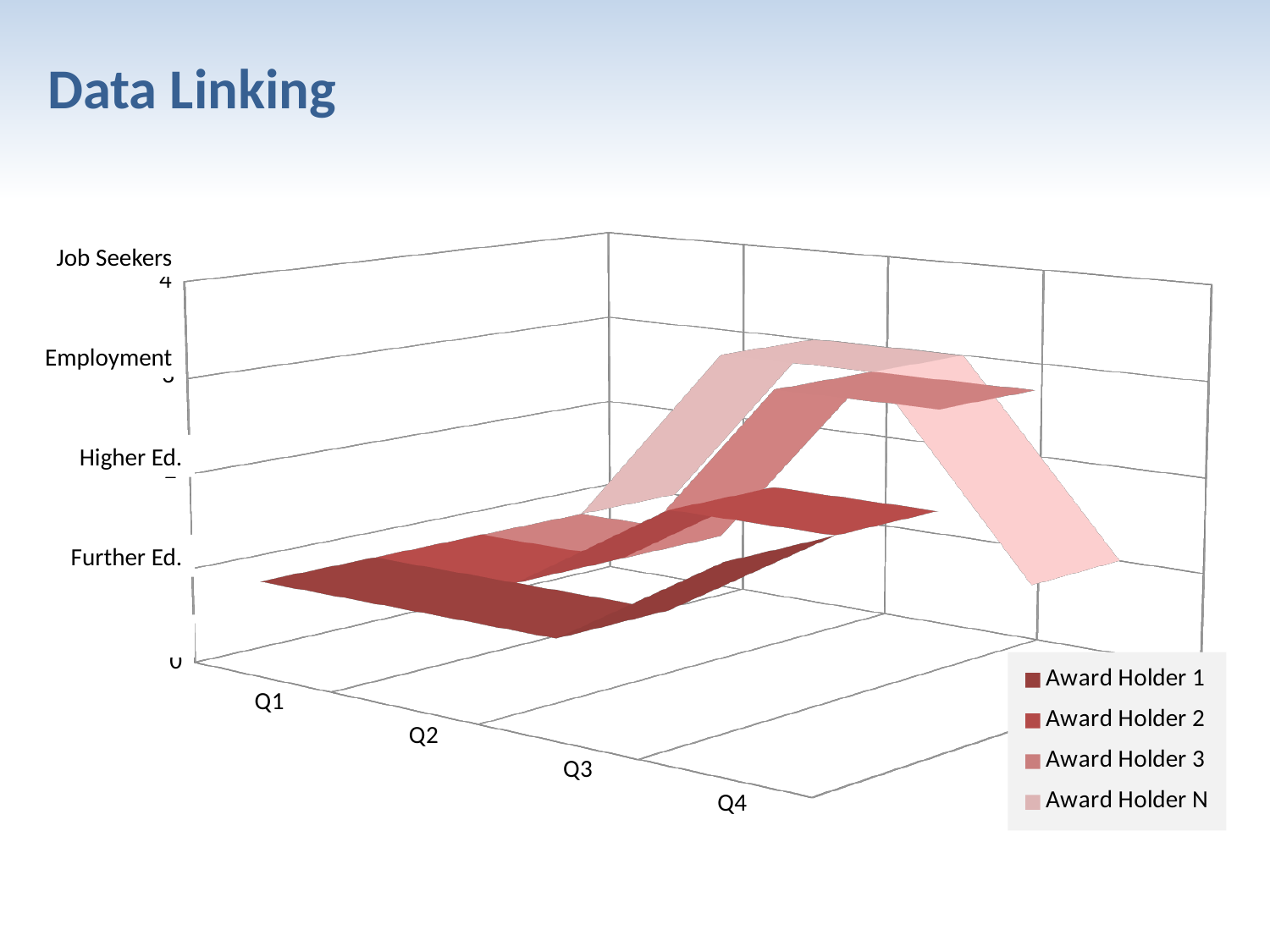
How many series does the legend list? 4 How many quarters are shown along the horizontal axis? 4 What is the highest numeric tick shown on the vertical axis? 4 What is the last series listed in the legend? Award Holder N What is the label of the first category on the horizontal axis? Q1 Which series is drawn in the darkest red? Award Holder 1 Which label appears at the top of the vertical axis? Job Seekers Which label appears lowest on the vertical axis, just above 0? Further Ed.